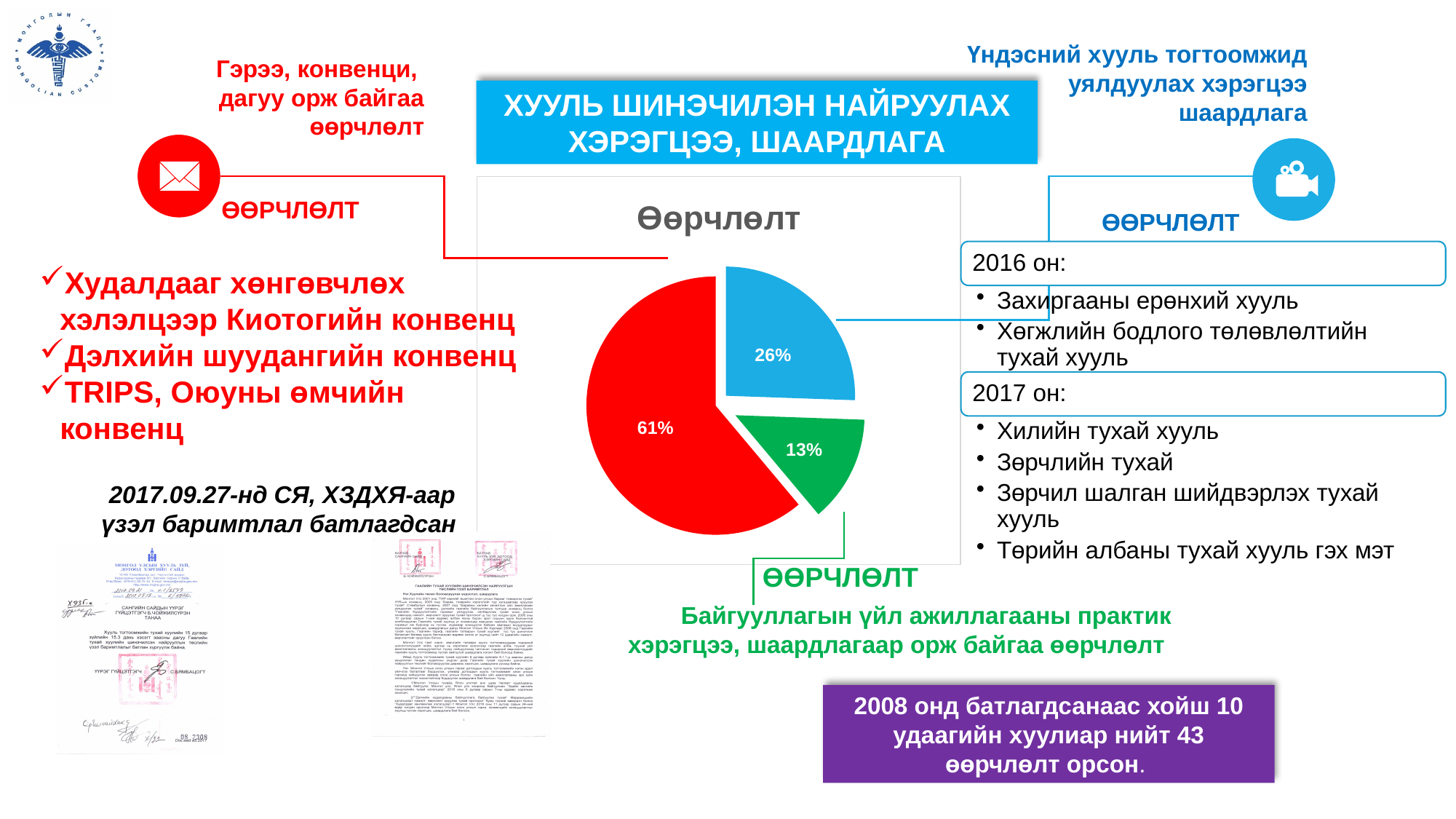
Which colour slice is the largest in the pie chart? red What share of the pie do the blue and green slices make up together? 39% What percentage is shown on the blue slice of the pie chart? 26% What is the difference in percentage points between the red slice and the blue slice? 35 Which is larger, the blue slice or the green slice? blue What is the title of the pie chart? Өөрчлөлт What kind of chart is shown on the slide? pie chart What is the difference in percentage points between the blue slice and the green slice? 13 How many slices does the pie chart have? 3 What percentage is shown on the red slice of the pie chart? 61% Which colour slice is the smallest in the pie chart? green What percentage is shown on the green slice of the pie chart? 13%